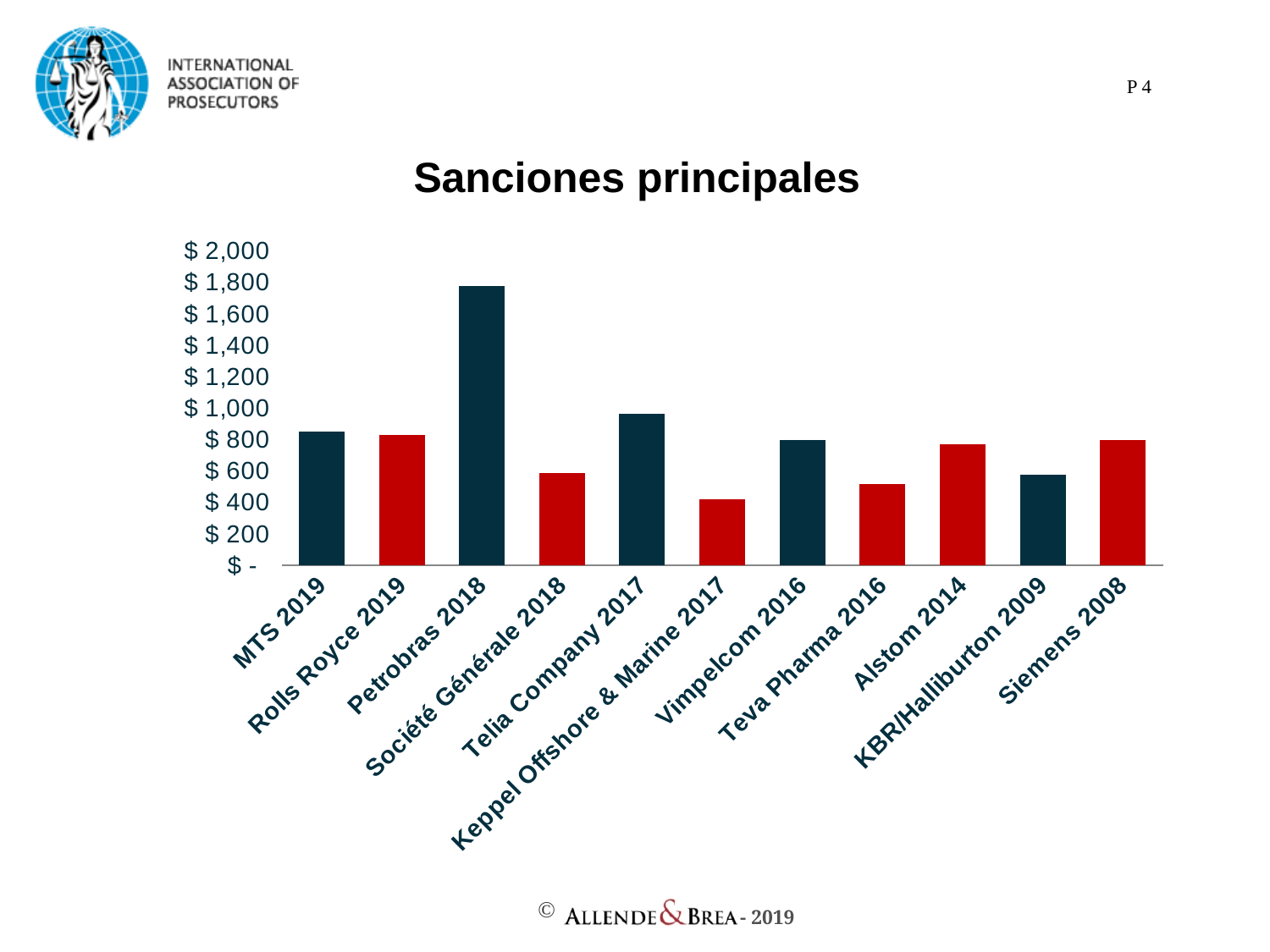
Is the value for Société Générale 2018 greater or less than $ 800? less Is the value for Petrobras 2018 greater or less than $ 1,600? greater What type of chart is shown on the slide? bar chart Which company has the lowest sanction in the chart? Keppel Offshore & Marine 2017 Which company has the highest sanction in the chart? Petrobras 2018 What is the title of the chart? Sanciones principales Which is larger, the value for Teva Pharma 2016 or the value for Alstom 2014? Alstom 2014 How many companies (categories) are shown on the x axis of the chart? 11 Which is larger, the value for Telia Company 2017 or the value for Keppel Offshore & Marine 2017? Telia Company 2017 Which is larger, the value for MTS 2019 or the value for Société Générale 2018? MTS 2019 Is the value for Keppel Offshore & Marine 2017 greater or less than $ 600? less